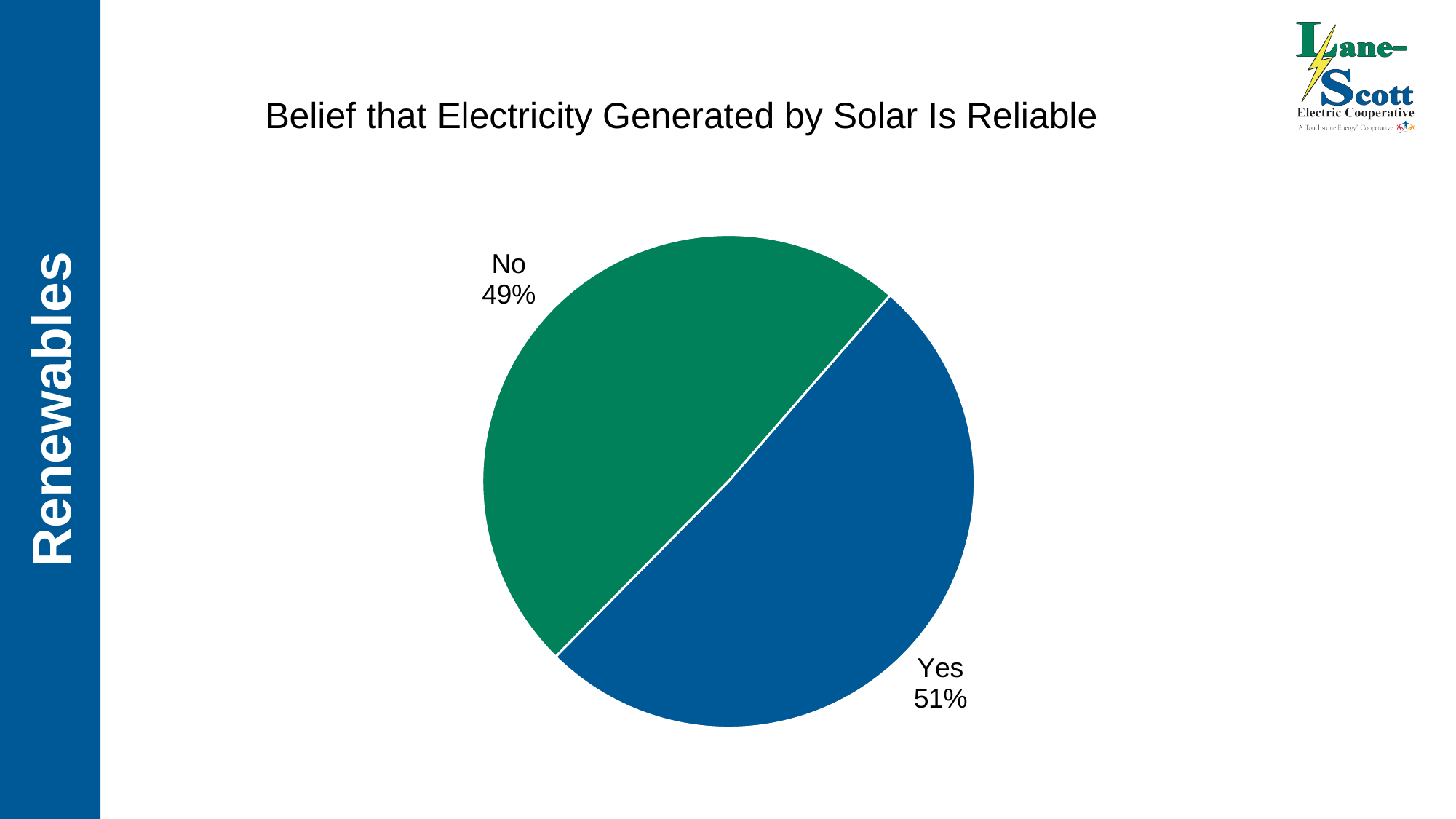
What percentage of respondents answered Yes? 51% What share of the pie does the No slice represent? 49% What colour is the Yes slice? blue How many slices does the pie chart have? 2 Which response has the larger share of the pie? Yes Which response has the smaller share of the pie? No What kind of chart is shown on the slide? pie chart What is the difference in percentage points between the Yes and No shares? 2 What percentage of respondents answered No? 49% Is the share for Yes larger or smaller than the share for No? larger What is the title of the chart? Belief that Electricity Generated by Solar Is Reliable